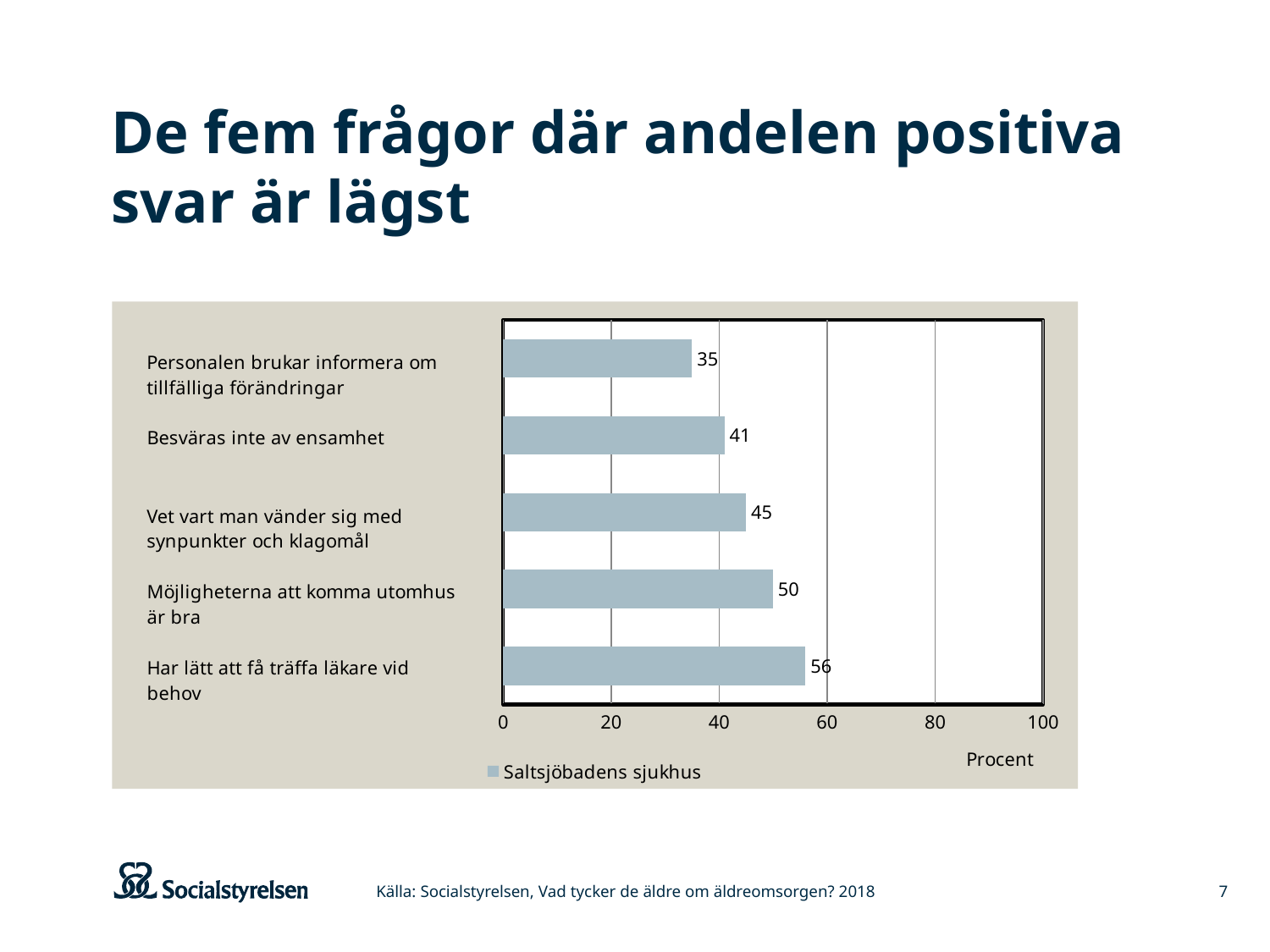
How many series does the legend list? 1 Is the value for "Har lätt att få träffa läkare vid behov" greater or less than 60? less What is the value for "Besväras inte av ensamhet"? 41 What kind of chart is shown on the slide? bar chart How many categories are shown in the chart? 5 What is the value for "Har lätt att få träffa läkare vid behov"? 56 Which is larger: the value for "Besväras inte av ensamhet" or the value for "Möjligheterna att komma utomhus är bra"? Möjligheterna att komma utomhus är bra What is the value for "Personalen brukar informera om tillfälliga förändringar"? 35 Which category has the highest value? Har lätt att få träffa läkare vid behov Which category has the lowest value? Personalen brukar informera om tillfälliga förändringar What is the difference between the values for "Möjligheterna att komma utomhus är bra" and "Vet vart man vänder sig med synpunkter och klagomål"? 5 What series name is shown in the chart legend? Saltsjöbadens sjukhus